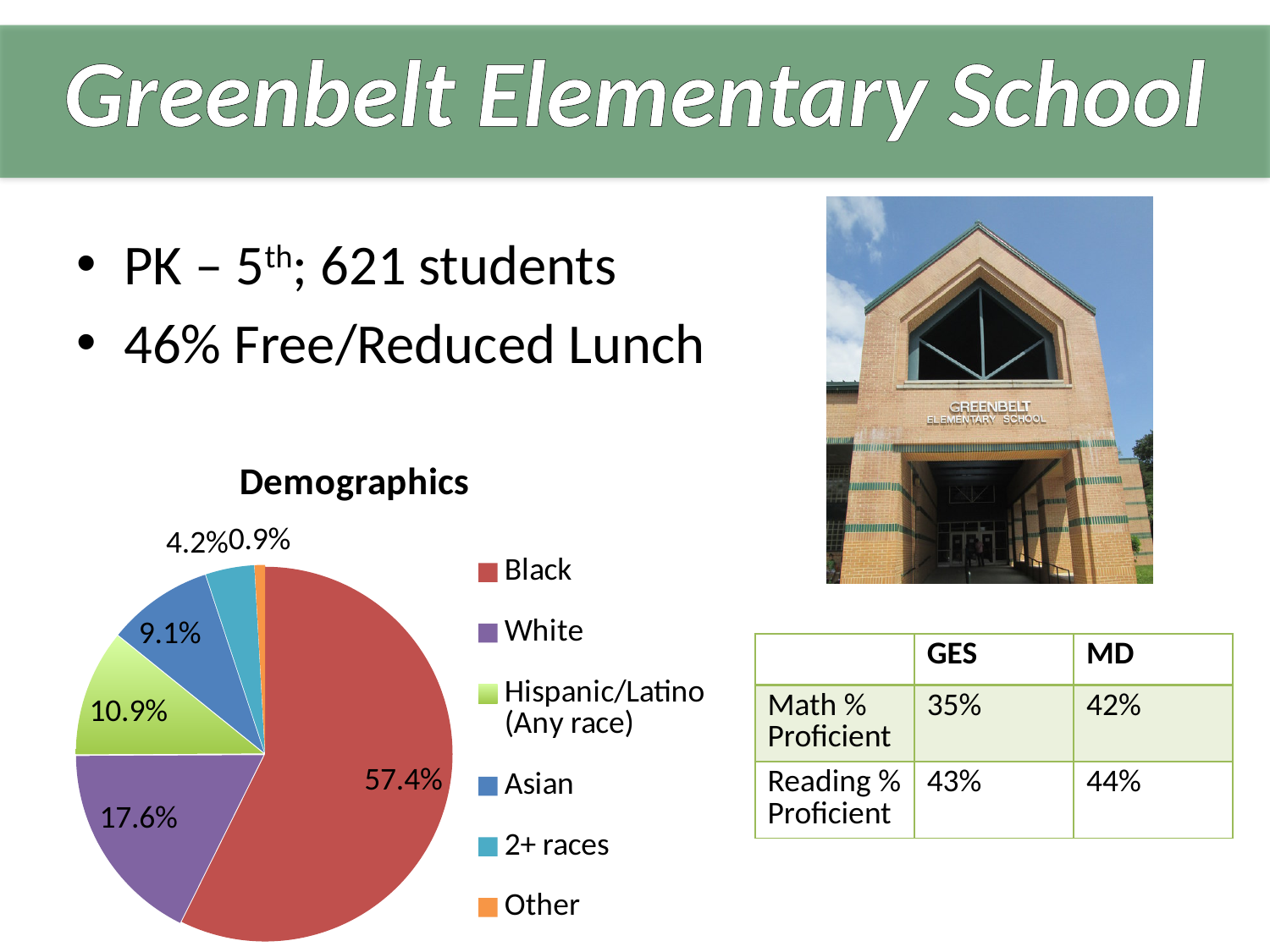
Which category has the largest slice in the Demographics pie chart? Black Which category has the smallest slice in the Demographics pie chart? Other What type of chart is the Demographics chart? pie chart How many categories does the Demographics pie chart show? 6 Which is larger in the Demographics pie chart, the Hispanic/Latino (Any race) share or the 2+ races share? Hispanic/Latino (Any race) What share of the Demographics pie is White? 17.6% What share of the Demographics pie is Black? 57.4% What is the title of the chart on the slide? Demographics What share of the Demographics pie is Asian? 9.1% What is the difference between the White and Asian shares in the Demographics pie chart? 8.5%